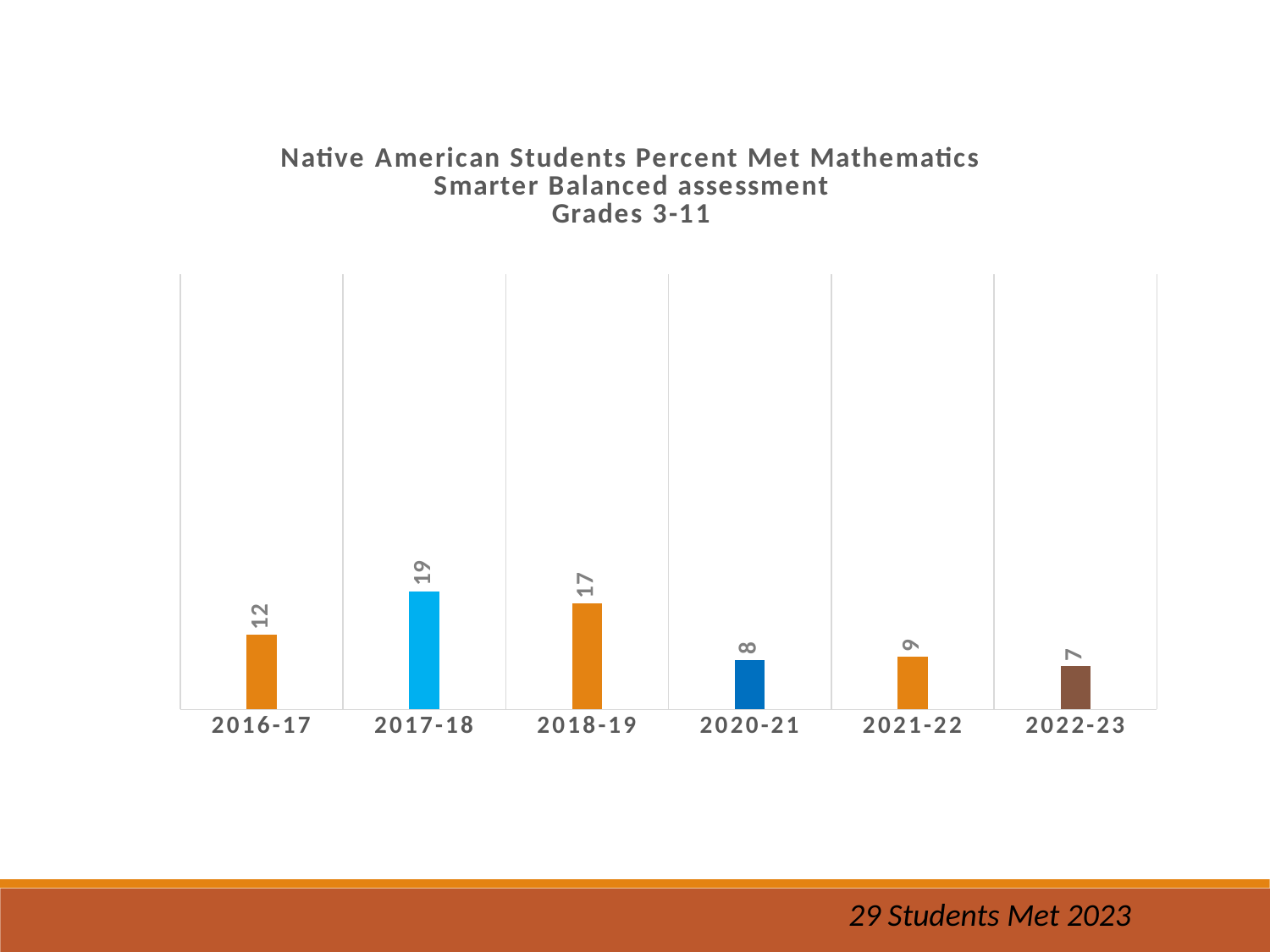
Which year has the lowest value? 2022-23 What is the value for 2017-18? 19 Which year has the highest value? 2017-18 What is the value for 2020-21? 8 What is the value for 2022-23? 7 What kind of chart is this? Bar chart Which is larger, the value for 2018-19 or the value for 2021-22? 2018-19 What is the difference between the values for 2017-18 and 2018-19? 2 What is the value for 2016-17? 12 What is the difference between the values for 2016-17 and 2022-23? 5 How many years are shown on the x axis? 6